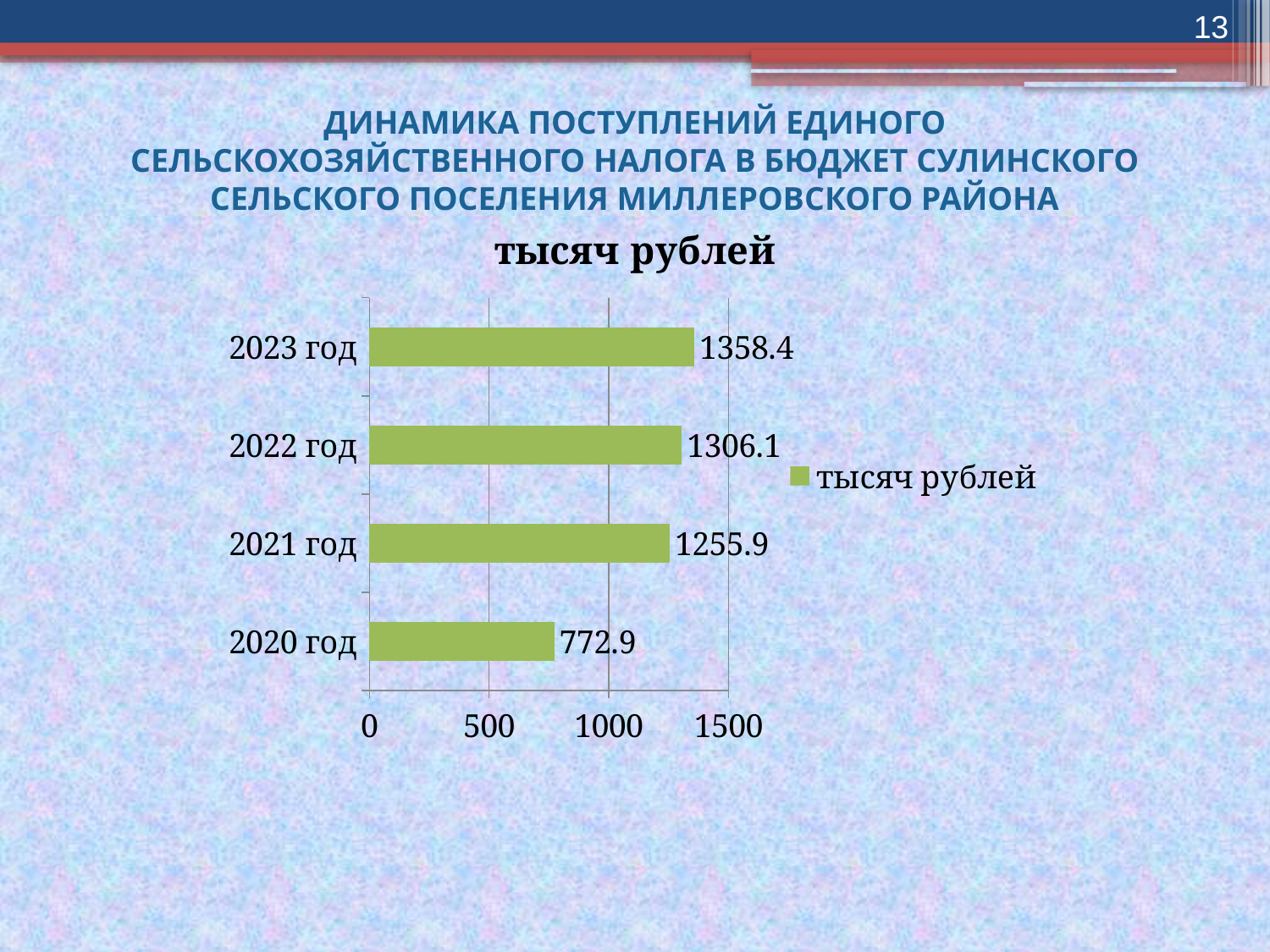
Which is larger, the value for 2022 год or the value for 2021 год? 2022 год How many years are shown in the chart? 4 What is the title of the chart? тысяч рублей What is the value for 2020 год? 772.9 Which year has the lowest value? 2020 год What is the difference between the values for 2023 год and 2022 год? 52.3 What kind of chart is shown on the slide? bar chart What is the value for 2021 год? 1255.9 Which year has the highest value? 2023 год What is the value for 2023 год? 1358.4 What is the difference between the values for 2021 год and 2020 год? 483.0 Is the value for 2020 год greater or less than 1000? less